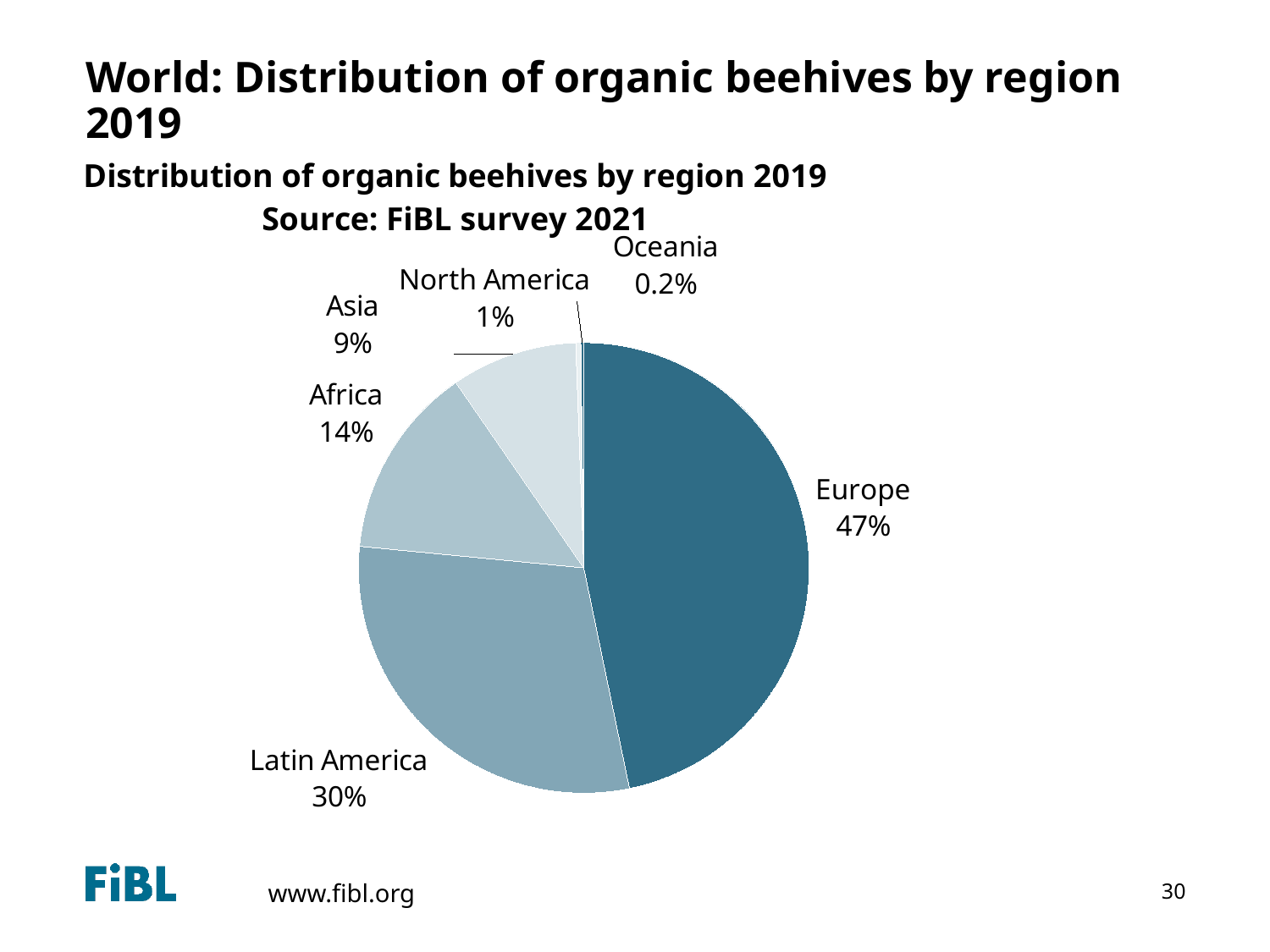
What share of organic beehives does Oceania hold? 0.2% What share of organic beehives does Africa hold? 14% What kind of chart is shown on the slide? Pie chart What is the difference in percentage points between Europe's share and Latin America's share? 17 What is the source given for the chart? FiBL survey 2021 Which region has the largest share of organic beehives? Europe What share of organic beehives does Latin America hold? 30% What share of organic beehives does Europe hold in the pie chart? 47% What is the combined share of Africa and Asia? 23% Which has a larger share of organic beehives, Africa or Asia? Africa Which region has the smallest share of organic beehives? Oceania How many regions are shown in the pie chart? 6